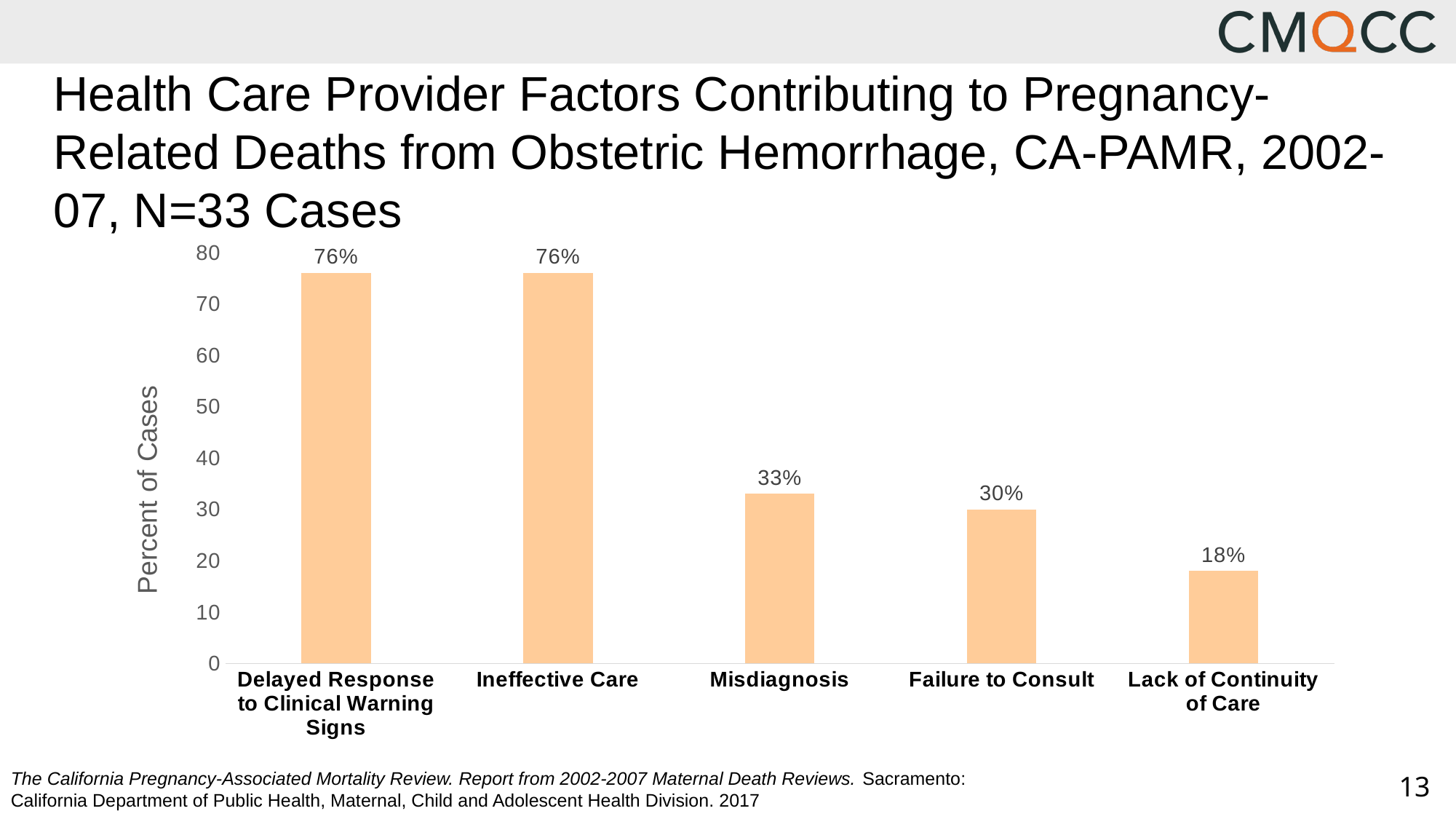
How many factors (categories) are shown on the chart? 5 Which has a higher percent of cases, Misdiagnosis or Lack of Continuity of Care? Misdiagnosis What percent of cases is shown for Failure to Consult? 30% What percent of cases is shown for Misdiagnosis? 33% What is the difference in percent of cases between Delayed Response to Clinical Warning Signs and Misdiagnosis? 43% What kind of chart is shown on the slide? Bar chart Which factor has the lowest percent of cases? Lack of Continuity of Care What is the label of the vertical axis? Percent of Cases What is the difference in percent of cases between Failure to Consult and Lack of Continuity of Care? 12% What percent of cases is shown for Ineffective Care? 76% Is the value for Failure to Consult greater or less than 40? less What percent of cases is shown for Lack of Continuity of Care? 18%